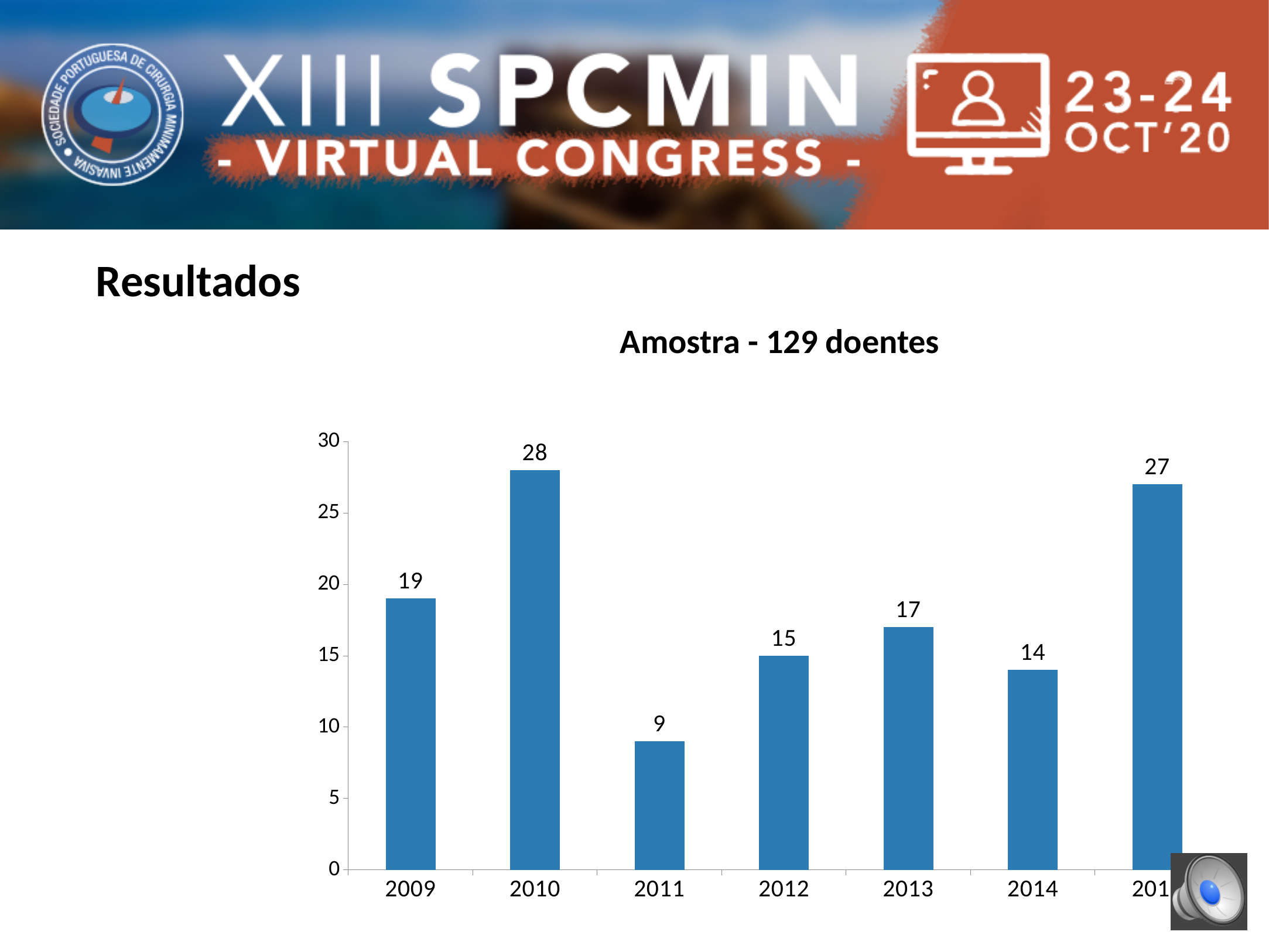
What is the value for 2013? 17 Which year has the lowest value? 2011 Which year has the highest value? 2010 What is the value for 2011? 9 What is the difference between the values for 2010 and 2011? 19 How many bars are shown in the chart? 7 What is the title of the chart? Amostra - 129 doentes What is the difference between the values for 2012 and 2014? 1 What is the value for 2010? 28 What is the value for 2009? 19 Which is larger, the value for 2009 or the value for 2013? 2009 What kind of chart is shown on the slide? Bar chart